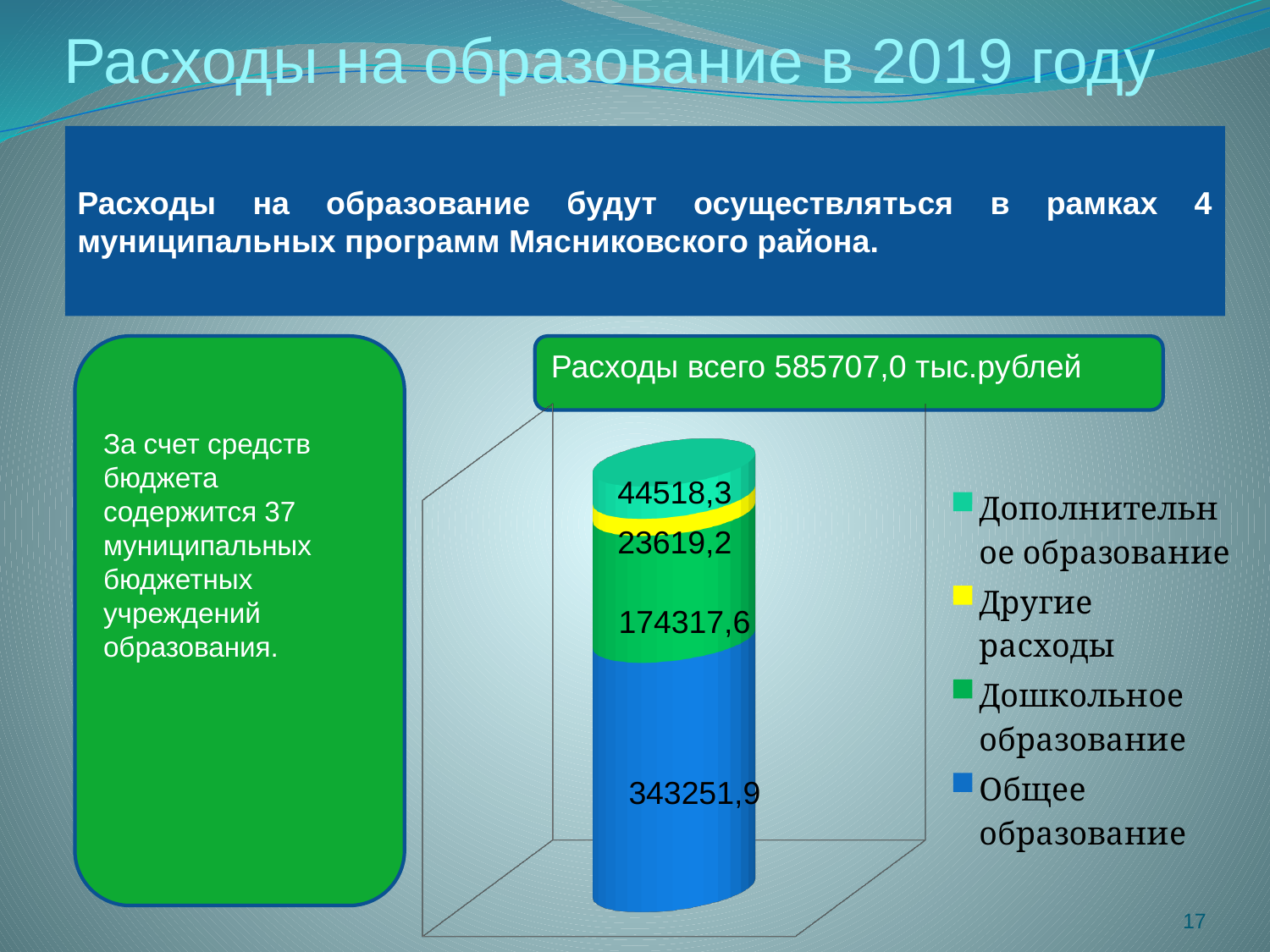
How many series does the legend list? 4 What is the value for Дополнительное образование on the chart? 44518,3 What is the value for Дошкольное образование on the chart? 174317,6 What is the value for Другие расходы on the chart? 23619,2 What is the total of the stacked bar on the chart? 585707,0 Which series has the largest value on the chart? Общее образование What kind of chart is shown on the slide? Stacked bar chart What is the value for Общее образование on the chart? 343251,9 What is the difference between the values for Дополнительное образование and Другие расходы? 20899,1 Which series has the smallest value on the chart? Другие расходы Which is larger: the value for Дополнительное образование or the value for Другие расходы? Дополнительное образование What is the difference between the values for Общее образование and Дошкольное образование? 168934,3